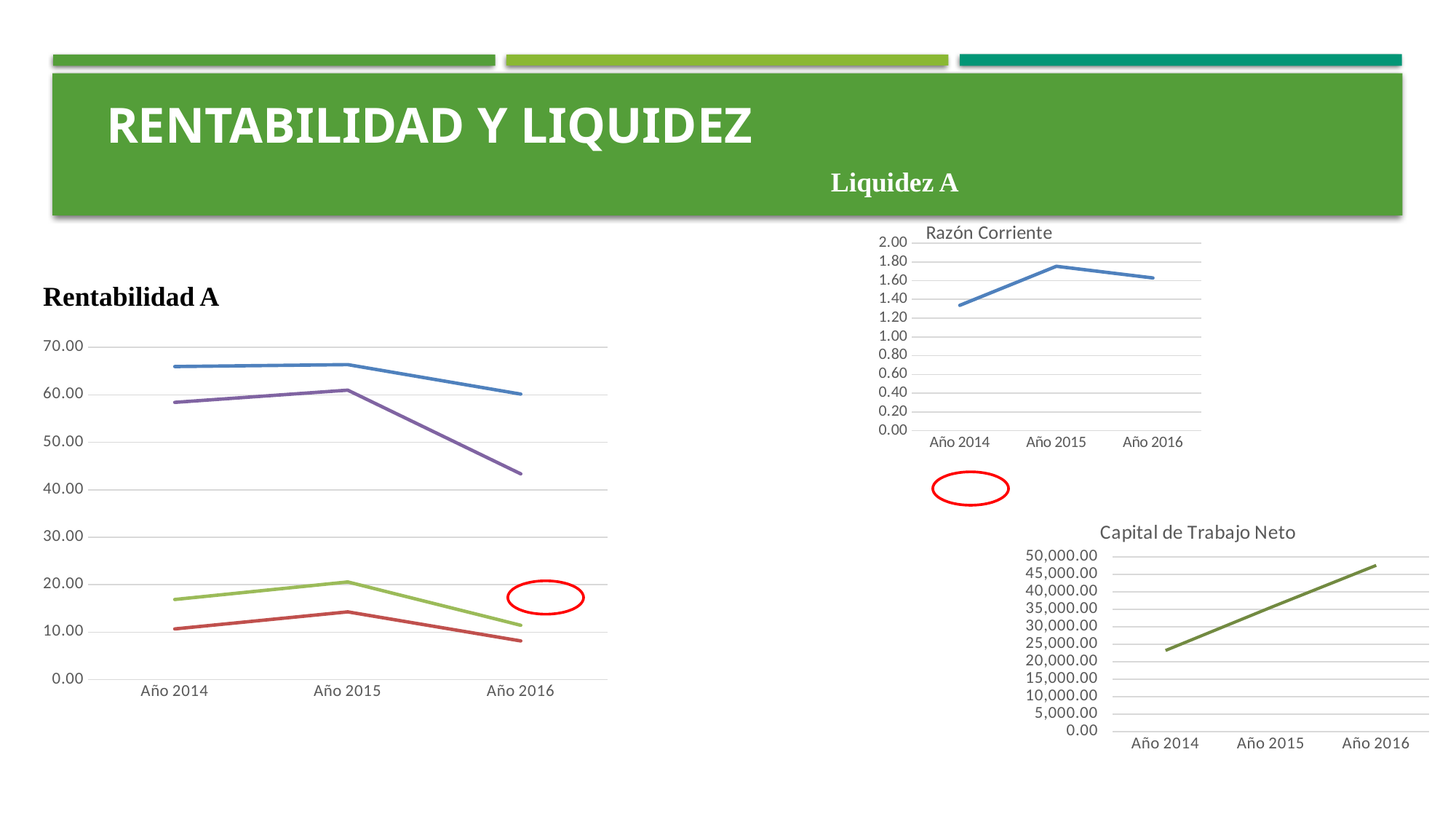
In the 'Razón Corriente' chart, which is larger, the value for Año 2015 or the value for Año 2016? Año 2015 What kind of chart is the 'Razón Corriente' chart? line chart In the 'Capital de Trabajo Neto' chart, is the value for Año 2016 greater or less than 45,000.00? greater In the 'Razón Corriente' chart, is the value for Año 2015 greater or less than 1.60? greater In the 'Capital de Trabajo Neto' chart, is the value for Año 2014 greater or less than 25,000.00? less In the 'Rentabilidad A' chart, does the topmost (blue) line rise or fall from Año 2015 to Año 2016? fall In the 'Razón Corriente' chart, which year has the highest value? Año 2015 How many lines are plotted in the 'Rentabilidad A' chart? 4 In the 'Capital de Trabajo Neto' chart, do the values rise or fall from Año 2014 to Año 2016? rise In the 'Razón Corriente' chart, which year has the lowest value? Año 2014 How many years are shown on the x axis of the 'Capital de Trabajo Neto' chart? 3